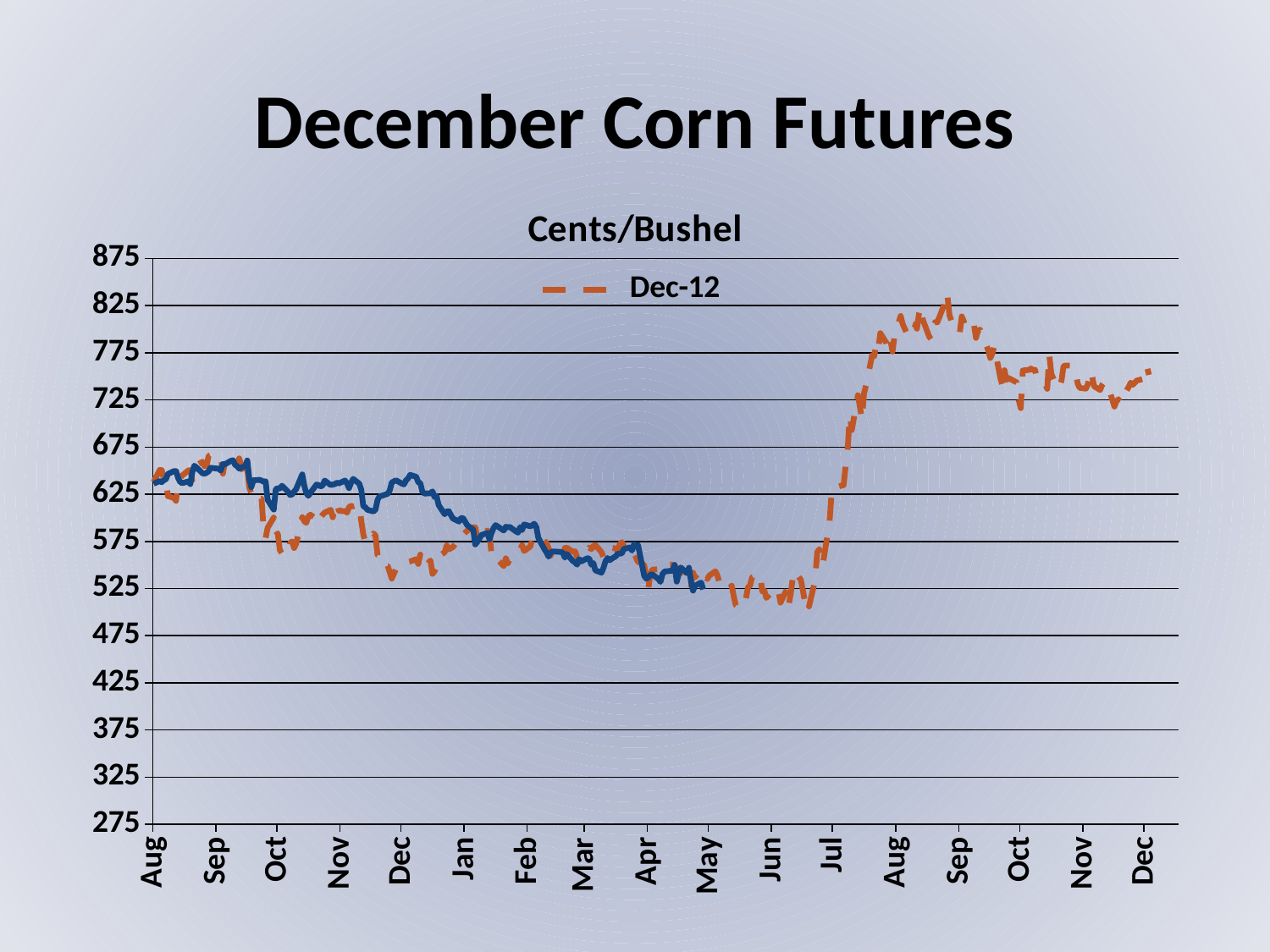
How many series does the legend list? 1 Is the value of the Dec-12 series at the first Aug greater or less than 625? greater What is the title of the chart on the slide? December Corn Futures Does the solid blue line rise or fall overall from the first Aug to May? fall Is the peak value of the Dec-12 series around the second Sep greater or less than 775? greater How many month labels are shown along the x axis? 17 What kind of chart is shown on the slide? line chart Is the value of the Dec-12 series at the final Dec greater or less than 725? greater Does the Dec-12 series rise or fall between Jul and the second Aug? rise What unit is shown in the chart's subtitle? Cents/Bushel